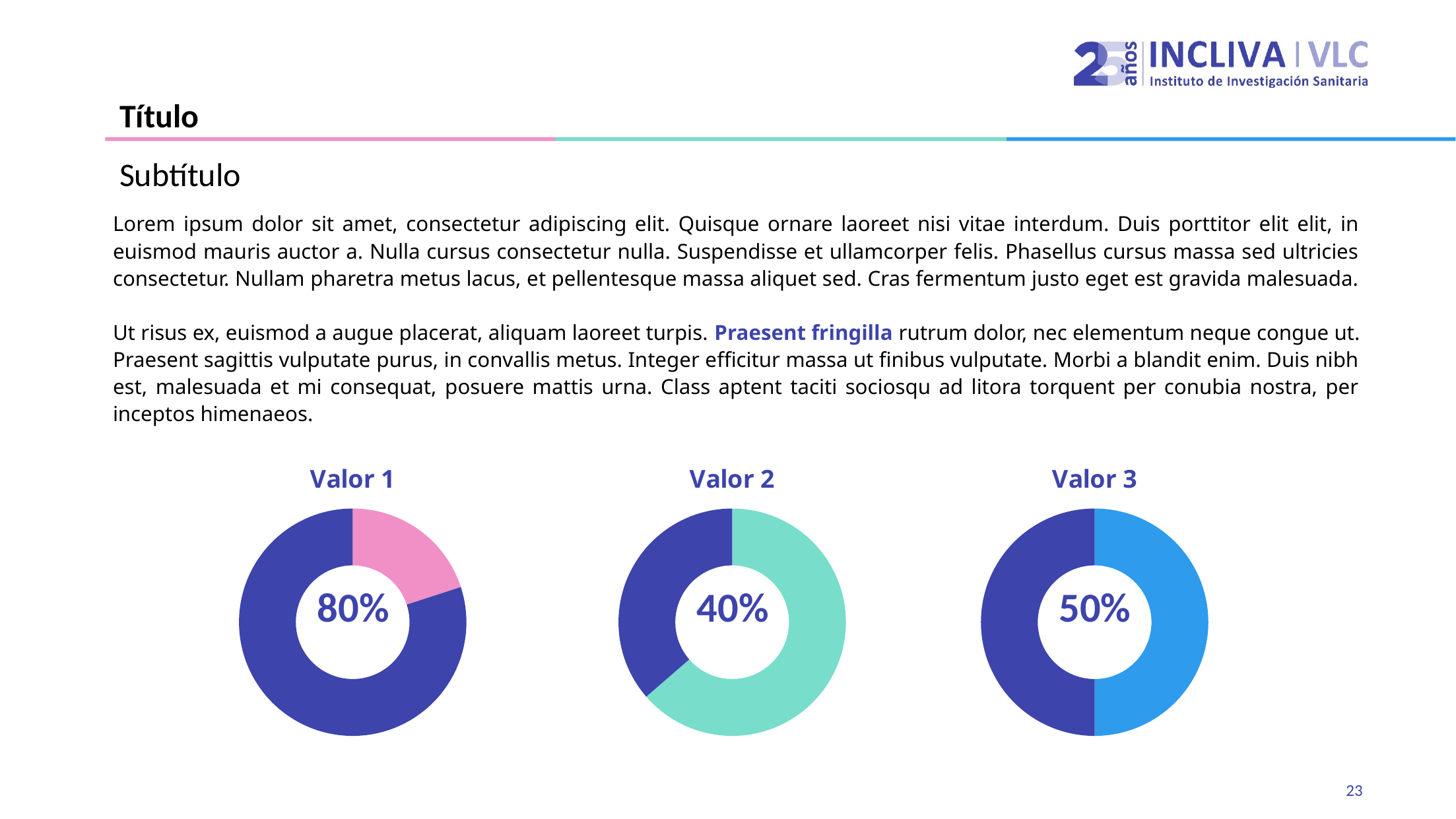
Which is larger, the percentage shown for Valor 3 or the percentage shown for Valor 2? Valor 3 What colour is the smaller slice in the Valor 1 chart? Pink What is the difference between the percentage shown for Valor 1 and the percentage shown for Valor 2? 40% What is the title of the chart on the right of the slide? Valor 3 What value is shown in the centre of the Valor 1 chart? 80% Which of the three charts (Valor 1, Valor 2, Valor 3) shows the highest percentage? Valor 1 How many slices does the Valor 3 doughnut chart have? 2 How many doughnut charts are shown on the slide? 3 Which of the three charts (Valor 1, Valor 2, Valor 3) shows the lowest percentage? Valor 2 What kind of chart is used for Valor 1? Doughnut chart What value is shown in the centre of the Valor 2 chart? 40% What value is shown in the centre of the Valor 3 chart? 50%